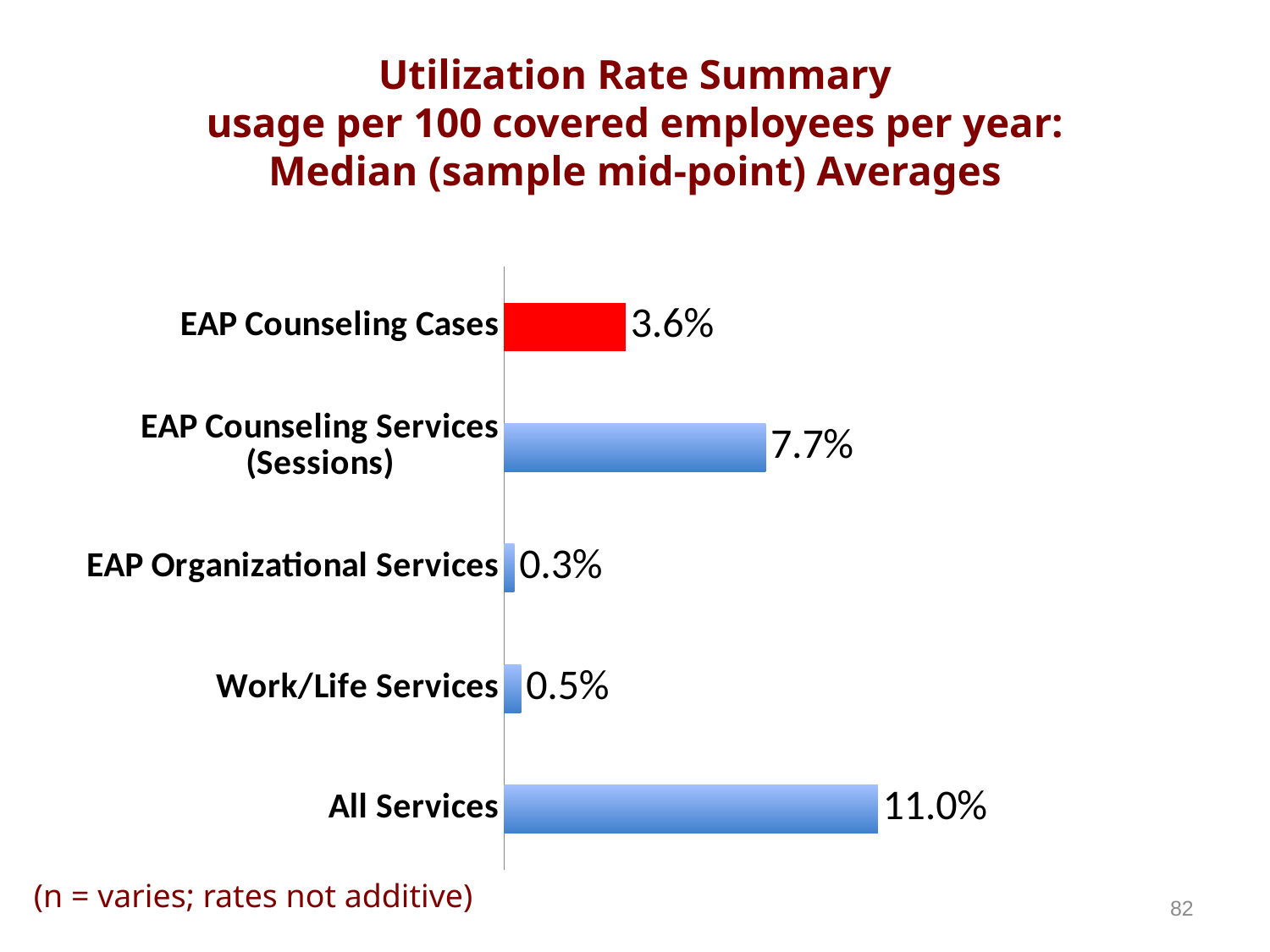
What is the value for EAP Counseling Services (Sessions)? 7.7% Which category's bar is coloured red? EAP Counseling Cases How many categories are shown in the chart? 5 Which category has the highest value? All Services Which is larger, the value for Work/Life Services or the value for EAP Organizational Services? Work/Life Services What is the value for EAP Organizational Services? 0.3% What is the value for Work/Life Services? 0.5% What is the value for All Services? 11.0% What is the difference between the values for EAP Counseling Services (Sessions) and EAP Counseling Cases? 4.1% What kind of chart is shown on the slide? Bar chart What is the value for EAP Counseling Cases? 3.6% Which category has the lowest value? EAP Organizational Services